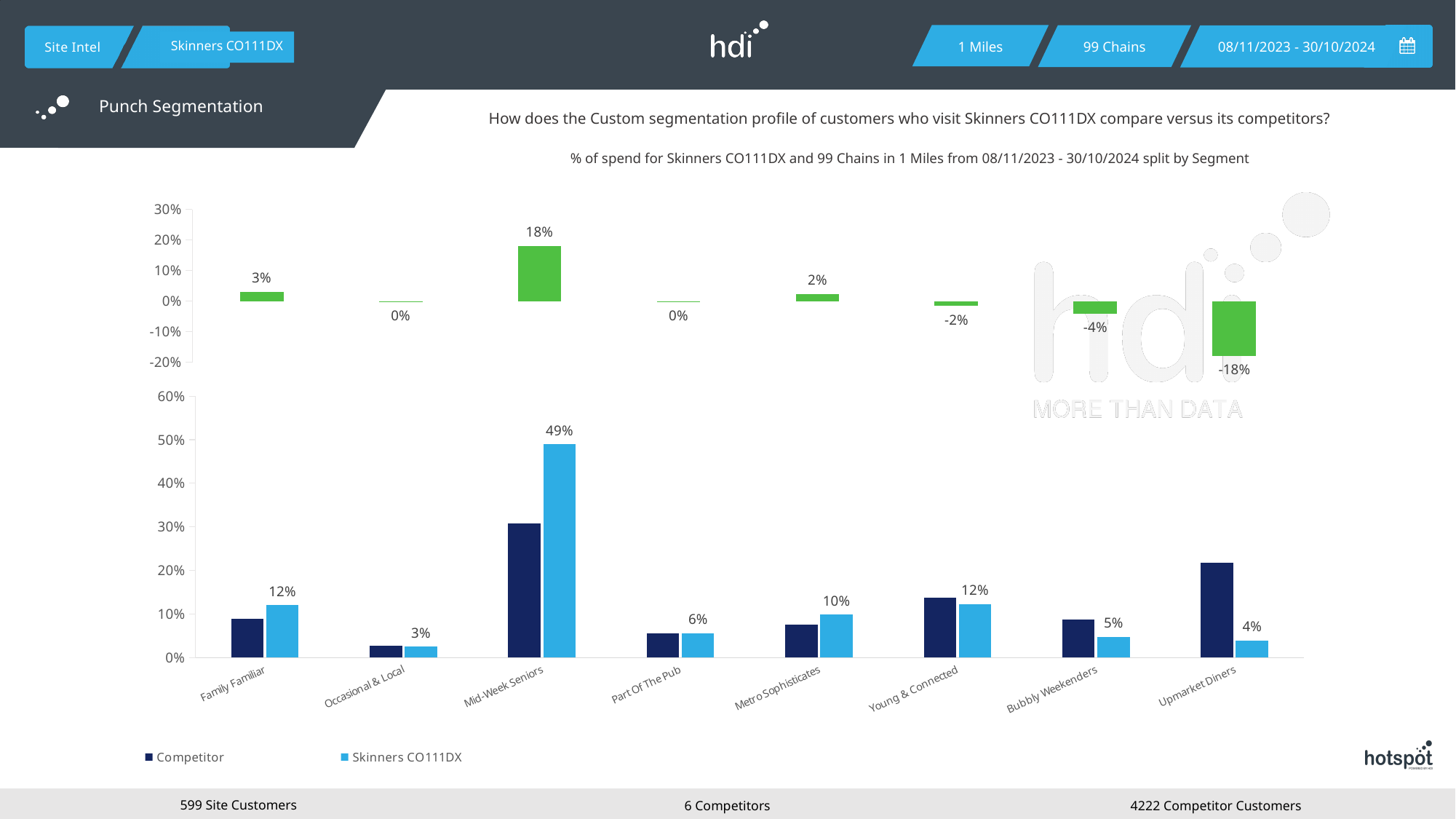
In the top chart, what is the value shown for Upmarket Diners? -18% In the top chart, what is the value shown for Bubbly Weekenders? -4% In the bottom chart, what is the difference between the Skinners CO111DX values for Mid-Week Seniors and Family Familiar? 37% In the bottom chart, which segment has the lowest Skinners CO111DX value? Occasional & Local In the top chart, which segment has the lowest value? Upmarket Diners In the bottom chart, what is the Skinners CO111DX value for Mid-Week Seniors? 49% In the bottom chart, which segment has the highest Skinners CO111DX value? Mid-Week Seniors In the top chart, which segment has the highest value? Mid-Week Seniors How many series does the legend of the bottom chart list? 2 How many segments are shown on the x axis of the bottom chart? 8 In the bottom chart, is the Competitor value for Young & Connected greater or less than 10%? greater In the bottom chart, what is the Skinners CO111DX value for Metro Sophisticates? 10%